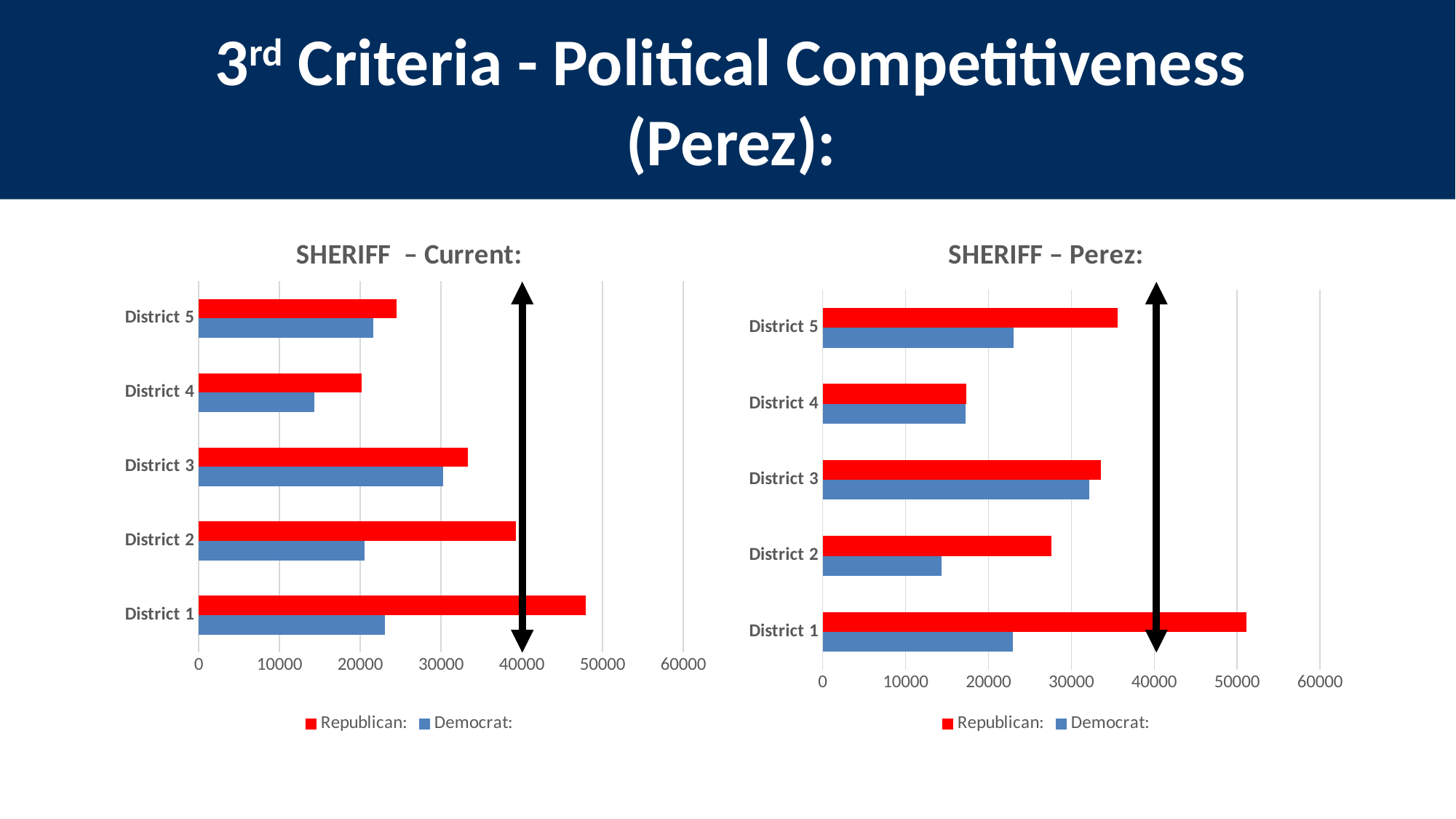
In the SHERIFF – Current chart, is the Republican value for District 1 greater or less than 40000? greater In the SHERIFF – Perez chart, for District 2, which is larger: the Republican value or the Democrat value? Republican How many districts are shown on the SHERIFF – Current chart? 5 In the SHERIFF – Perez chart, what colour represents the Democrat series? blue What kind of chart is the SHERIFF – Current chart? bar chart In the SHERIFF – Perez chart, which district has the lowest Republican value? District 4 How many series does the legend of the SHERIFF – Perez chart list? 2 In the SHERIFF – Perez chart, is the Republican value for District 1 greater or less than 40000? greater In the SHERIFF – Current chart, which district has the highest Republican value? District 1 In the SHERIFF – Current chart, which district has the lowest Democrat value? District 4 In the SHERIFF – Current chart, is the Democrat value for District 4 greater or less than 20000? less In the SHERIFF – Perez chart, which district has the highest Republican value? District 1